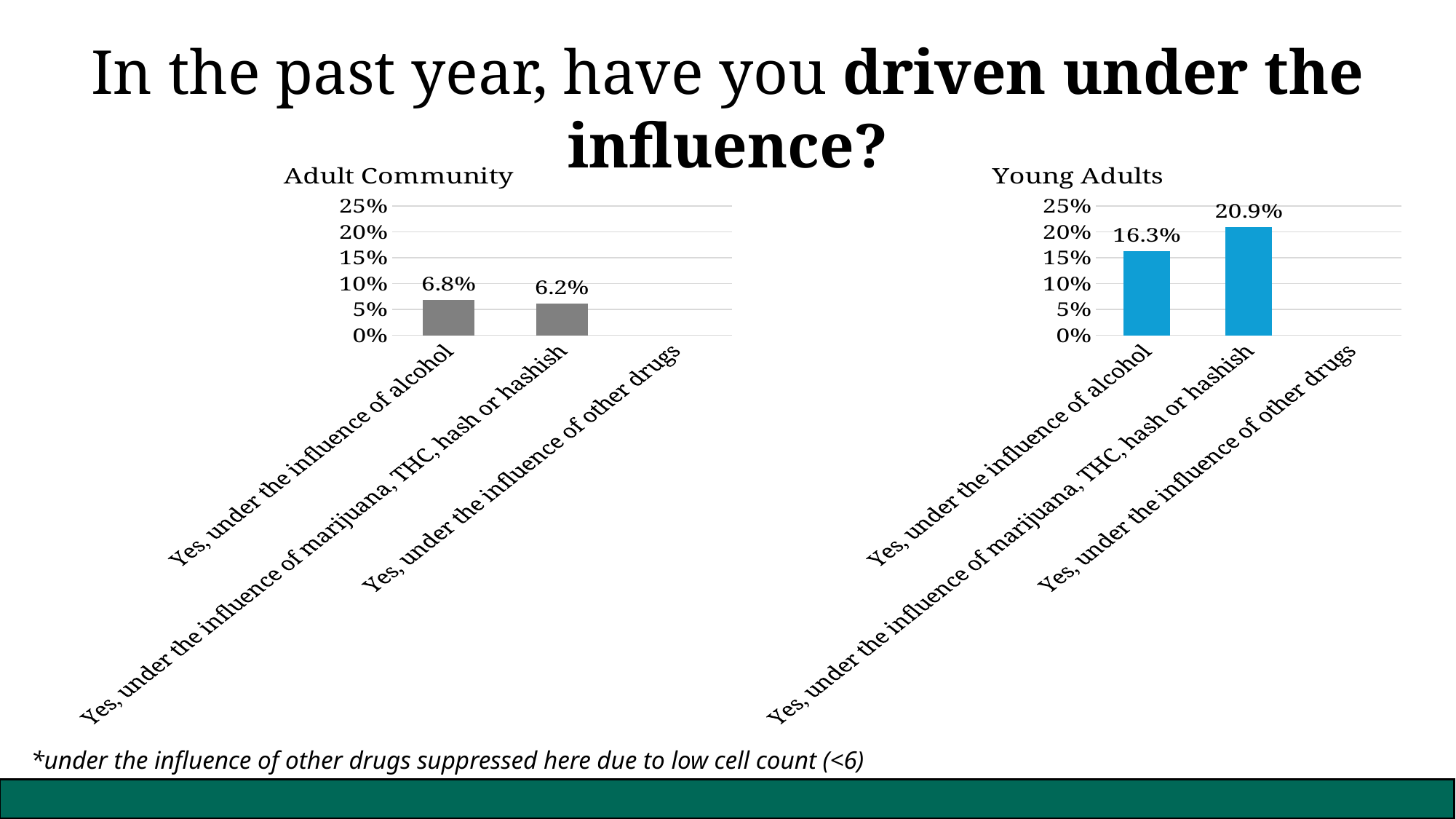
In the Young Adults chart, what is the value for 'Yes, under the influence of alcohol'? 16.3% How many category labels are shown on the x axis of the Adult Community chart? 3 In the Young Adults chart, is the value for 'Yes, under the influence of marijuana, THC, hash or hashish' greater or less than 20%? greater In the Young Adults chart, which category has the highest value? Yes, under the influence of marijuana, THC, hash or hashish Which is larger: the alcohol value in the Young Adults chart or the alcohol value in the Adult Community chart? Young Adults In the Young Adults chart, what is the difference between the marijuana value and the alcohol value? 4.6% In the Adult Community chart, which category has the lowest plotted value? Yes, under the influence of marijuana, THC, hash or hashish In the Young Adults chart, what is the value for 'Yes, under the influence of marijuana, THC, hash or hashish'? 20.9% In the Adult Community chart, what is the value for 'Yes, under the influence of marijuana, THC, hash or hashish'? 6.2% What kind of chart is the Young Adults chart? bar chart In the Adult Community chart, what is the value for 'Yes, under the influence of alcohol'? 6.8% In the Adult Community chart, what is the difference between the alcohol value and the marijuana value? 0.6%